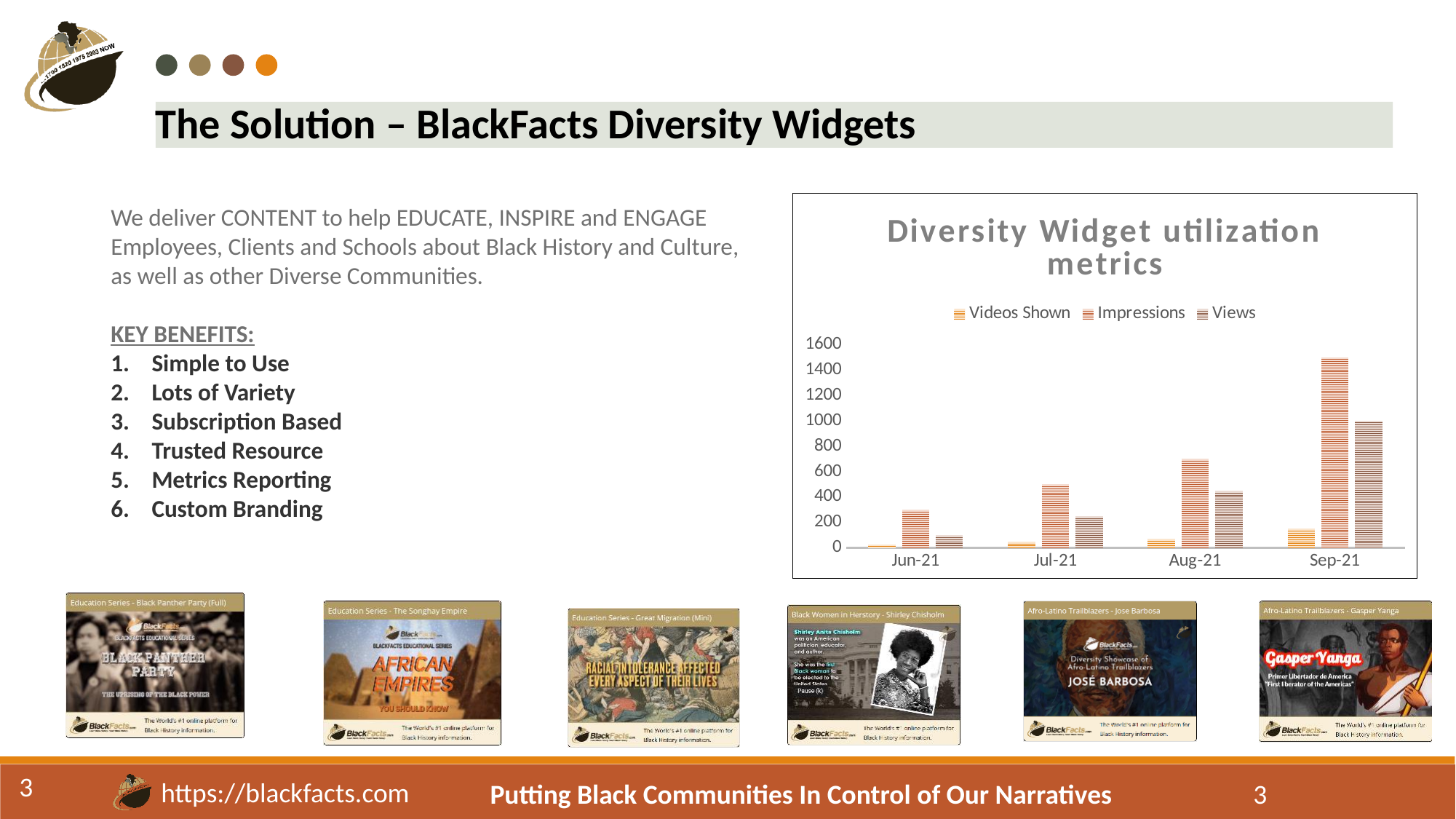
In which month are Impressions highest? Sep-21 Is the value for Impressions in Sep-21 greater or less than 1400? greater Is the value for Views in Sep-21 greater or less than 800? greater Is the value for Views in Jun-21 greater or less than 200? less Do Impressions rise or fall from Jun-21 to Sep-21? rise What kind of chart is shown on the slide? bar chart In which month are Views lowest? Jun-21 How many series does the chart's legend list? 3 In Sep-21, which is larger: Impressions or Views? Impressions How many months are shown on the x axis of the chart? 4 What is the title of the chart? Diversity Widget utilization metrics